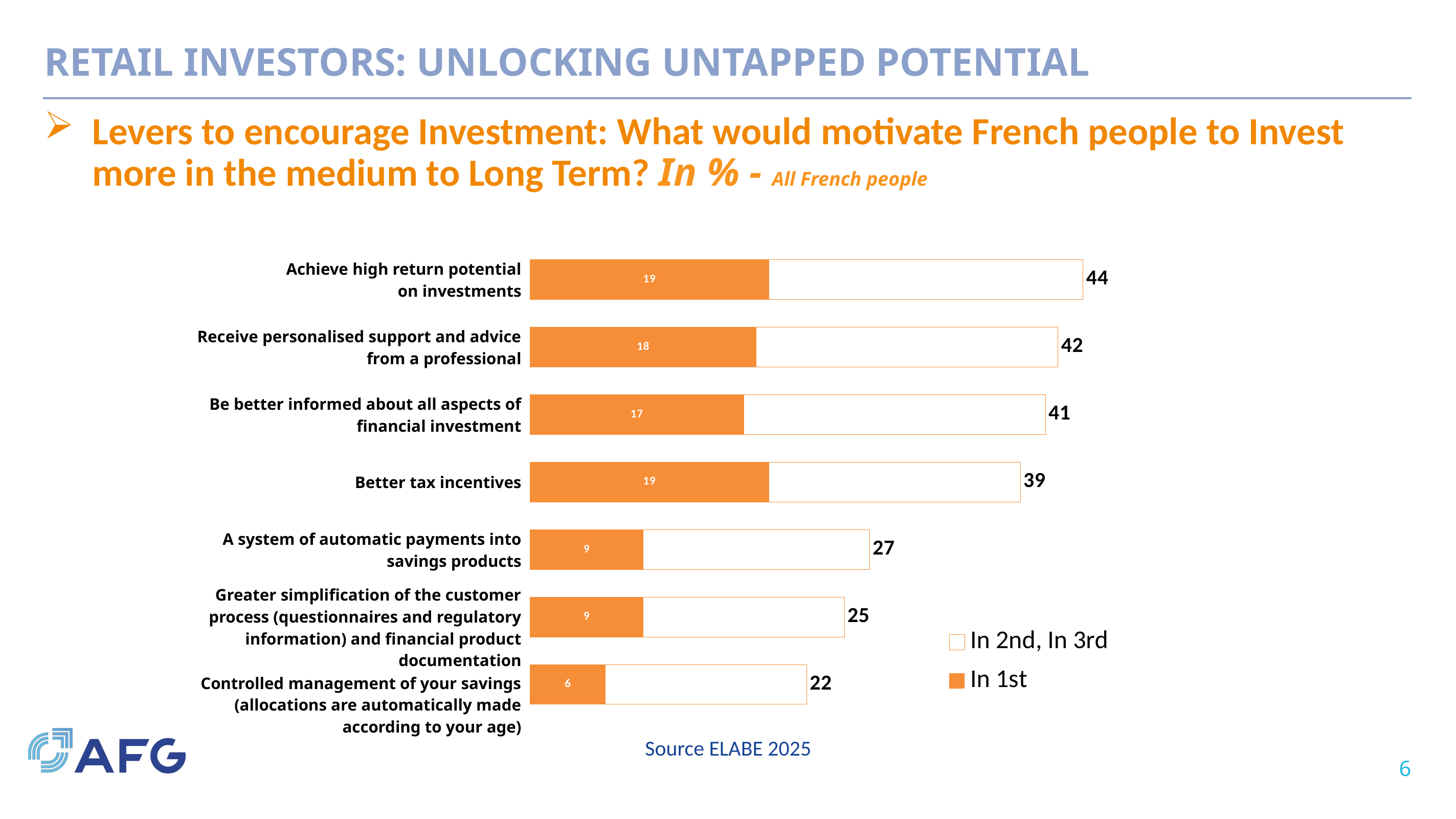
How many levers (categories) are shown in the chart? 7 What is the 'In 2nd, In 3rd' value for 'Be better informed about all aspects of financial investment', given the total of 41 and 'In 1st' of 17? 24 Which lever has the highest total value? Achieve high return potential on investments Which has a larger total value: 'A system of automatic payments into savings products' or 'Greater simplification of the customer process (questionnaires and regulatory information) and financial product documentation'? A system of automatic payments into savings products Which colour represents the 'In 1st' series in the legend? Orange How many series does the legend list? 2 What is the 'In 1st' value for 'Controlled management of your savings (allocations are automatically made according to your age)'? 6 What is the total value shown for 'Receive personalised support and advice from a professional'? 42 What kind of chart is shown on the slide? Stacked bar chart What is the 'In 1st' value for 'Better tax incentives'? 19 Which lever has the lowest 'In 1st' value? Controlled management of your savings (allocations are automatically made according to your age) What is the difference between the total values for 'Achieve high return potential on investments' and 'Better tax incentives'? 5